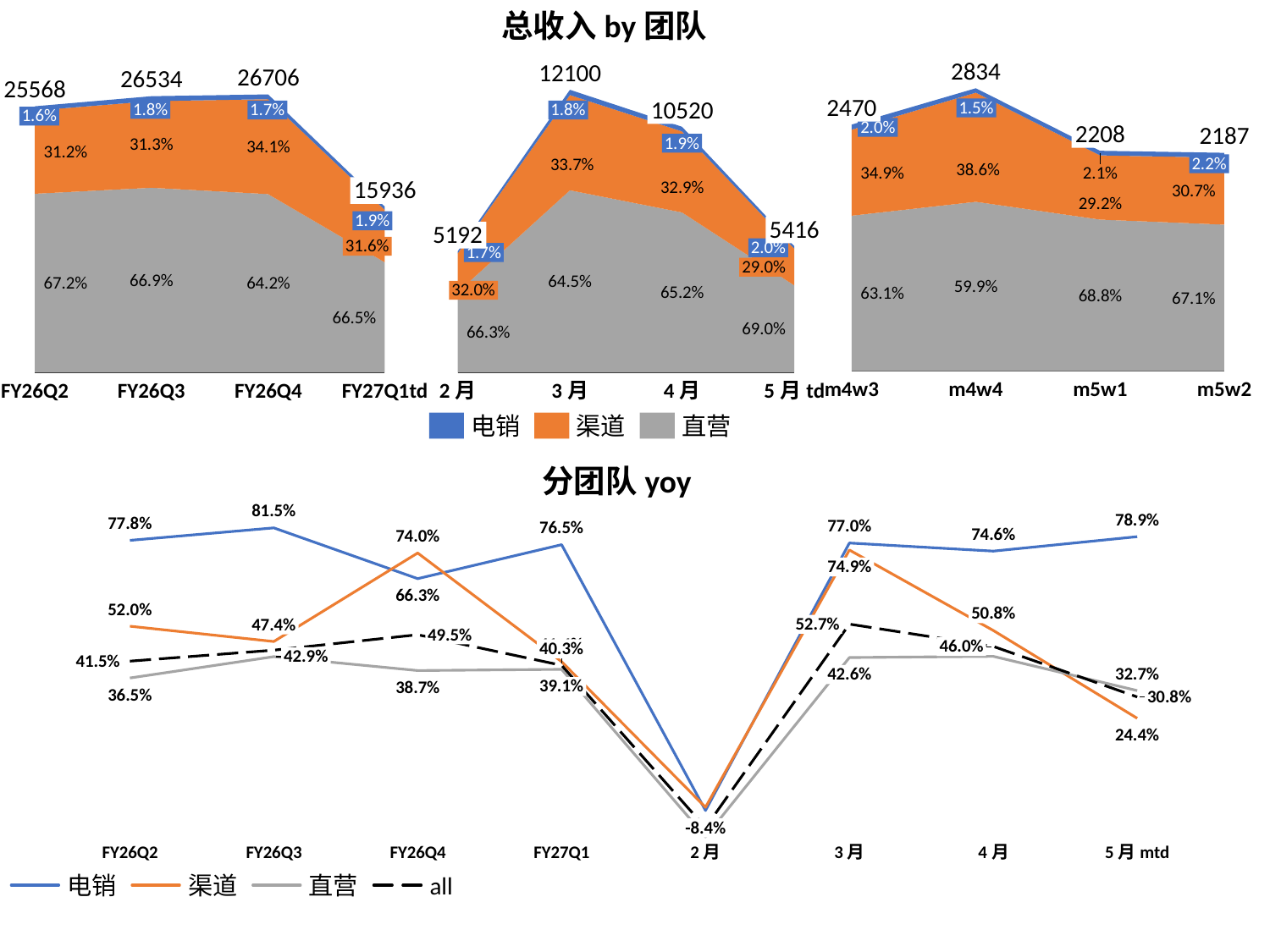
In the top chart (总收入 by 团队), which month among 2月, 3月, 4月 and 5月td has the highest total? 3月 How many series does the legend of the top chart (总收入 by 团队) list? 3 In the bottom chart (分团队 yoy), what is the 电销 value for FY26Q3? 81.5% In the bottom chart (分团队 yoy), which is larger at 4月: 电销 or 渠道? 电销 How many series does the legend of the bottom chart (分团队 yoy) list? 4 What kind of chart is the bottom chart (分团队 yoy)? line chart In the bottom chart (分团队 yoy), what is the 渠道 value for FY26Q4? 74.0% How many categories are on the x axis of the bottom chart (分团队 yoy)? 8 In the top chart (总收入 by 团队), what share does 直营 account for in m4w4? 59.9% In the top chart (总收入 by 团队), what is the difference between the FY26Q4 total and the FY26Q2 total? 1138 In the top chart (总收入 by 团队), what share does 渠道 account for in 5月td? 29.0% In the top chart (总收入 by 团队), what is the total revenue shown for FY26Q4? 26706